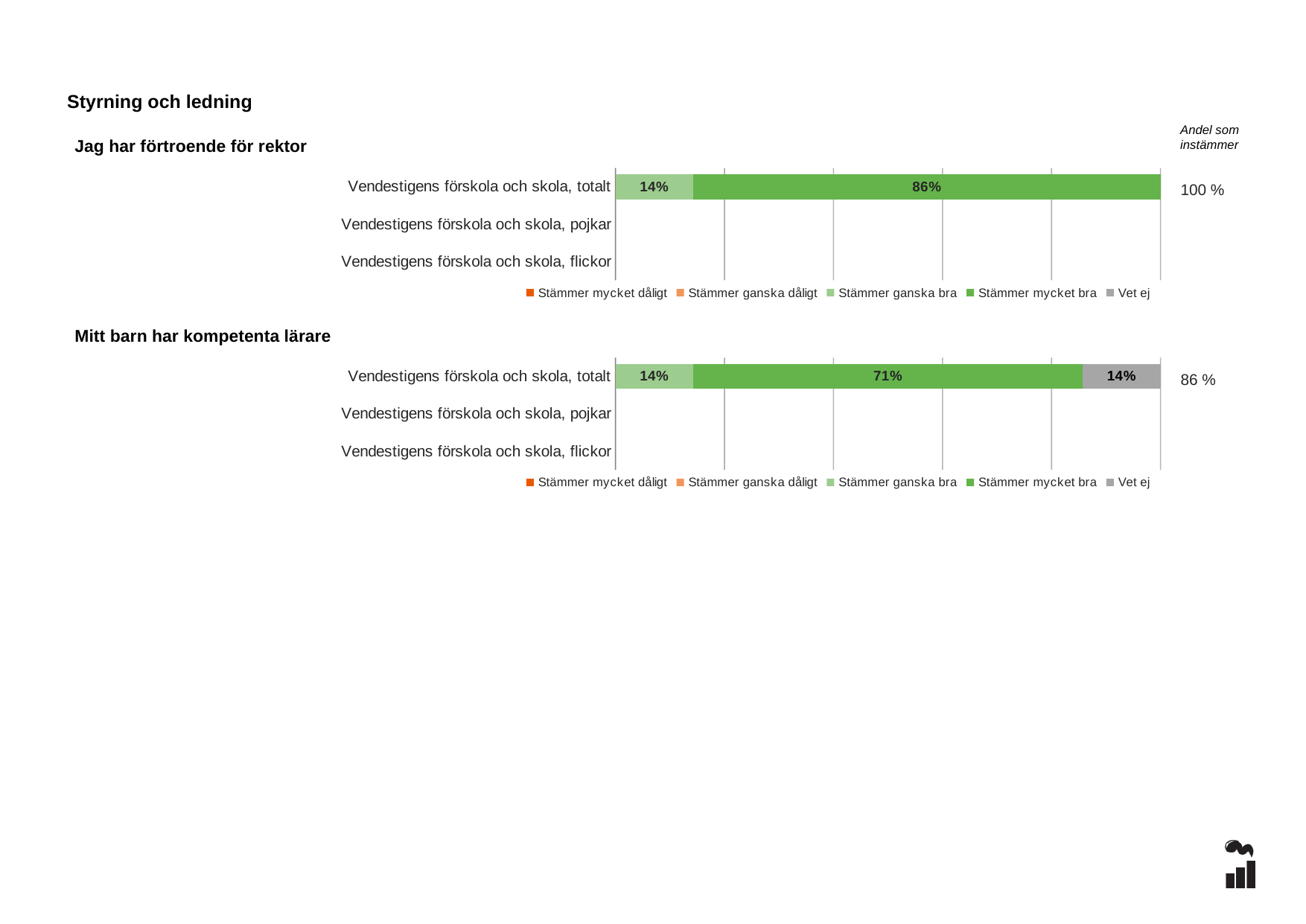
In the chart 'Jag har förtroende för rektor', what is the difference between 'Stämmer mycket bra' and 'Stämmer ganska bra' for Vendestigens förskola och skola, totalt? 72% How many series does the legend of the chart 'Mitt barn har kompetenta lärare' list? 5 How many categories are shown on the y axis of the chart 'Jag har förtroende för rektor'? 3 In the chart 'Jag har förtroende för rektor', what is the value for 'Stämmer mycket bra' for Vendestigens förskola och skola, totalt? 86% In the chart 'Mitt barn har kompetenta lärare', what is the value for 'Stämmer mycket bra' for Vendestigens förskola och skola, totalt? 71% What is the 'Andel som instämmer' value shown next to the chart 'Mitt barn har kompetenta lärare'? 86 % In the chart 'Mitt barn har kompetenta lärare', what is the difference between 'Stämmer mycket bra' and 'Vet ej' for Vendestigens förskola och skola, totalt? 57% In the chart 'Mitt barn har kompetenta lärare', what is the value for 'Vet ej' for Vendestigens förskola och skola, totalt? 14% In the chart 'Jag har förtroende för rektor', what is the value for 'Stämmer ganska bra' for Vendestigens förskola och skola, totalt? 14% In the chart 'Jag har förtroende för rektor', which series has the largest share for Vendestigens förskola och skola, totalt? Stämmer mycket bra In the chart 'Mitt barn har kompetenta lärare', which is larger for Vendestigens förskola och skola, totalt: 'Stämmer ganska bra' or 'Stämmer mycket bra'? Stämmer mycket bra What kind of chart is 'Mitt barn har kompetenta lärare'? Stacked bar chart